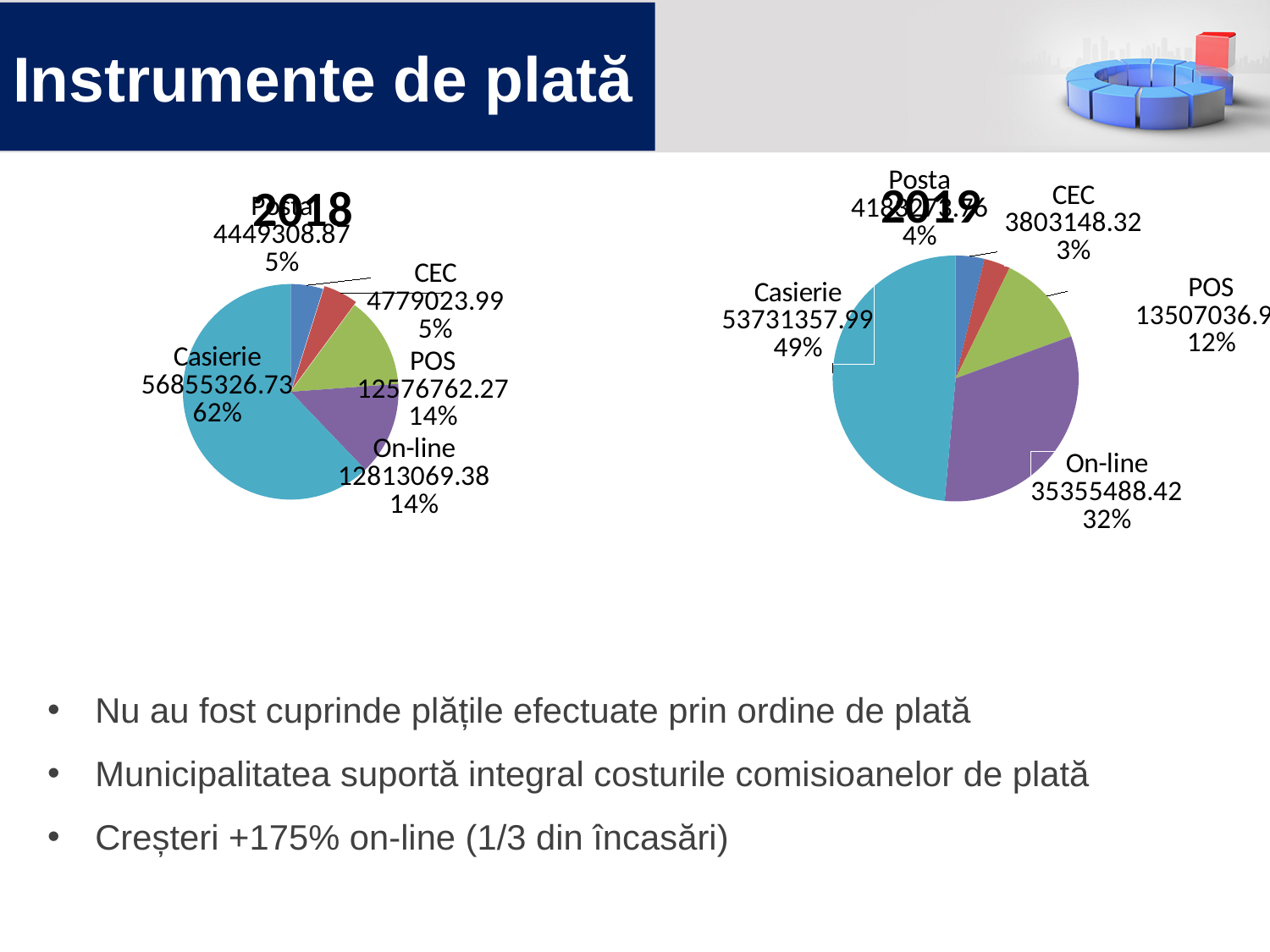
How many categories does the 2018 pie chart show? 5 In the 2018 pie chart, what is the difference between the On-line value and the POS value? 236307.11 In the 2019 pie chart, what share of the pie does Casierie represent? 49% In the 2019 pie chart, which is larger, On-line or POS? On-line In the 2018 pie chart, which category has the largest slice? Casierie In the 2019 pie chart, which category has the smallest slice? CEC In the 2018 pie chart, what is the value for Casierie? 56855326.73 In the 2019 pie chart, what share of the pie does CEC represent? 3% What kind of chart is the 2019 chart? Pie chart In the 2019 pie chart, what is the value for On-line? 35355488.42 In the 2018 pie chart, what is the value for CEC? 4779023.99 In the 2018 pie chart, what share of the pie does On-line represent? 14%